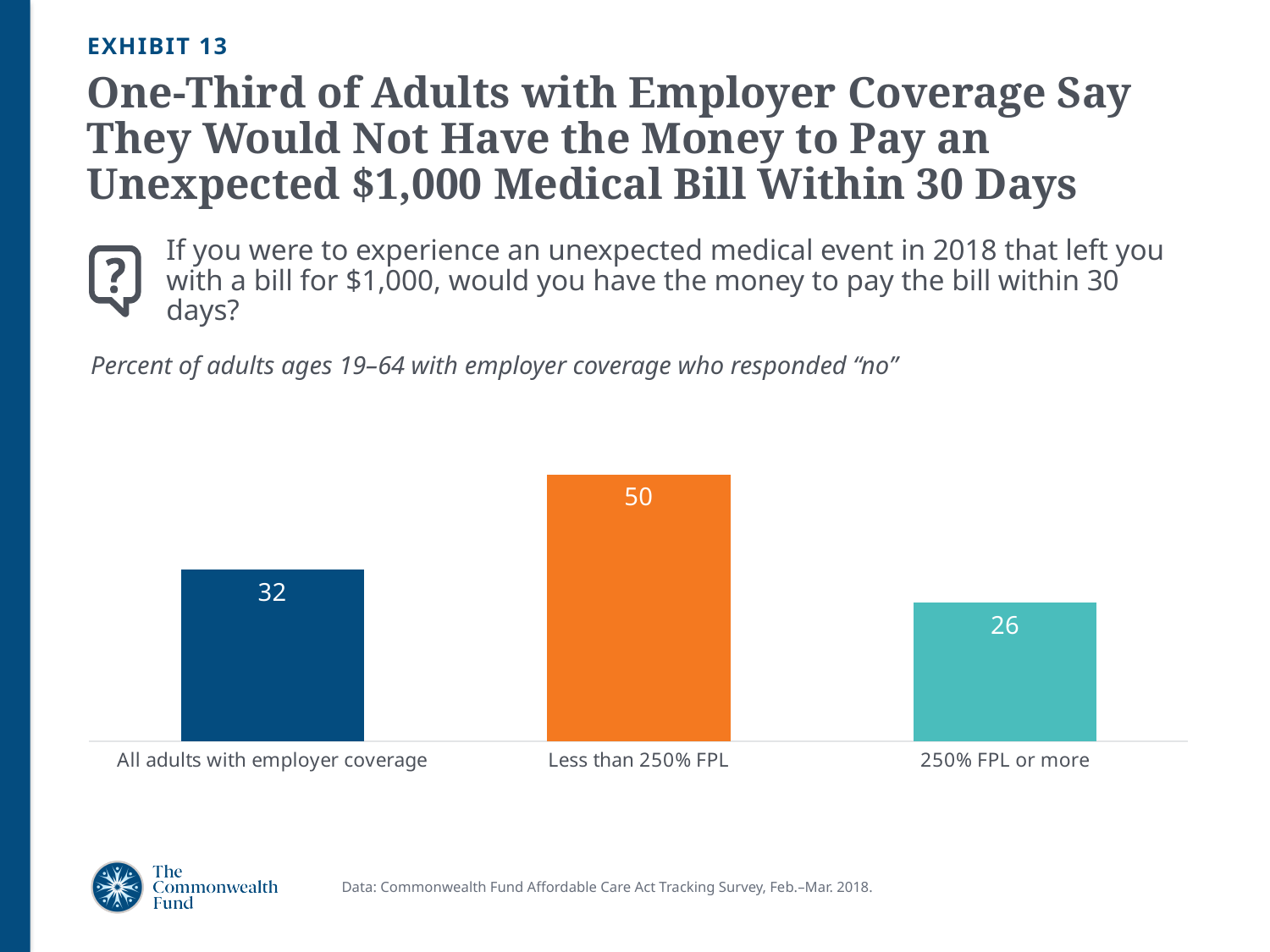
What is the difference between the values for "Less than 250% FPL" and "All adults with employer coverage"? 18 What is the value for "All adults with employer coverage"? 32 What does the chart measure, according to the subtitle above it? Percent of adults ages 19–64 with employer coverage who responded "no" Which is larger, the value for "All adults with employer coverage" or the value for "250% FPL or more"? All adults with employer coverage What is the value for "250% FPL or more"? 26 How many categories are shown in the chart? 3 What kind of chart is shown on the slide? Bar chart What is the value for "Less than 250% FPL"? 50 Which category has the highest value? Less than 250% FPL Which category has the lowest value? 250% FPL or more What colour is the bar for "Less than 250% FPL"? Orange What is the difference between the values for "Less than 250% FPL" and "250% FPL or more"? 24